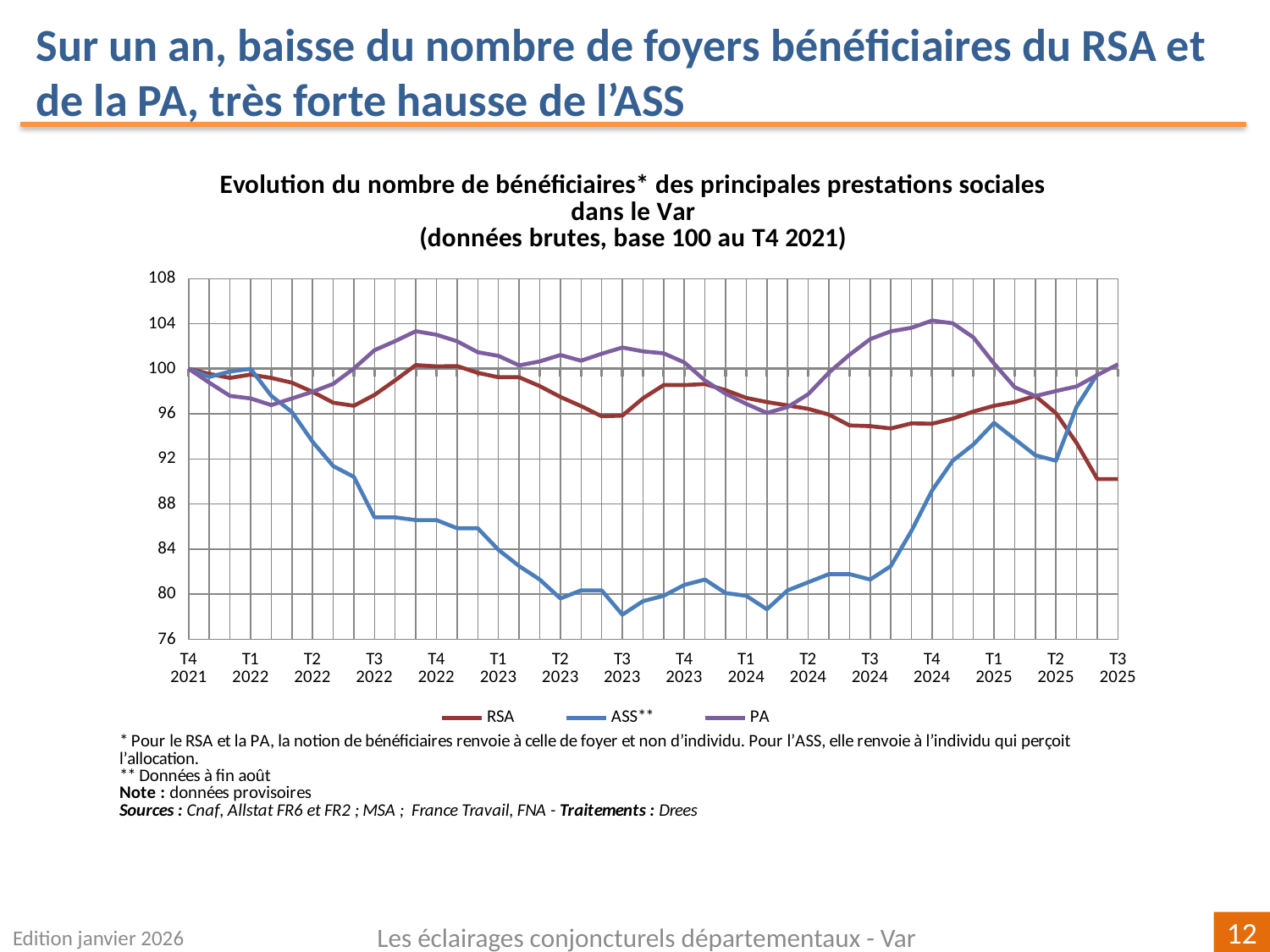
What is the value of the RSA series at T4 2021? 100 At T3 2024, which is larger: the RSA value or the PA value? PA How many quarter labels are shown along the x axis? 16 Is the value of the PA series at T4 2024 greater or less than 100? greater Is the value of the RSA series at T3 2025 greater or less than 92? less Is the value of the ASS** series at T3 2023 greater or less than 80? less What is the base period for the index (base 100) according to the chart title? T4 2021 Does the ASS** series rise or fall between T4 2021 and T3 2023? fall How many series does the legend list? 3 What kind of chart is shown on the slide? line chart Which series has the highest value at T4 2022? PA Which series has the lowest value at T3 2023? ASS**